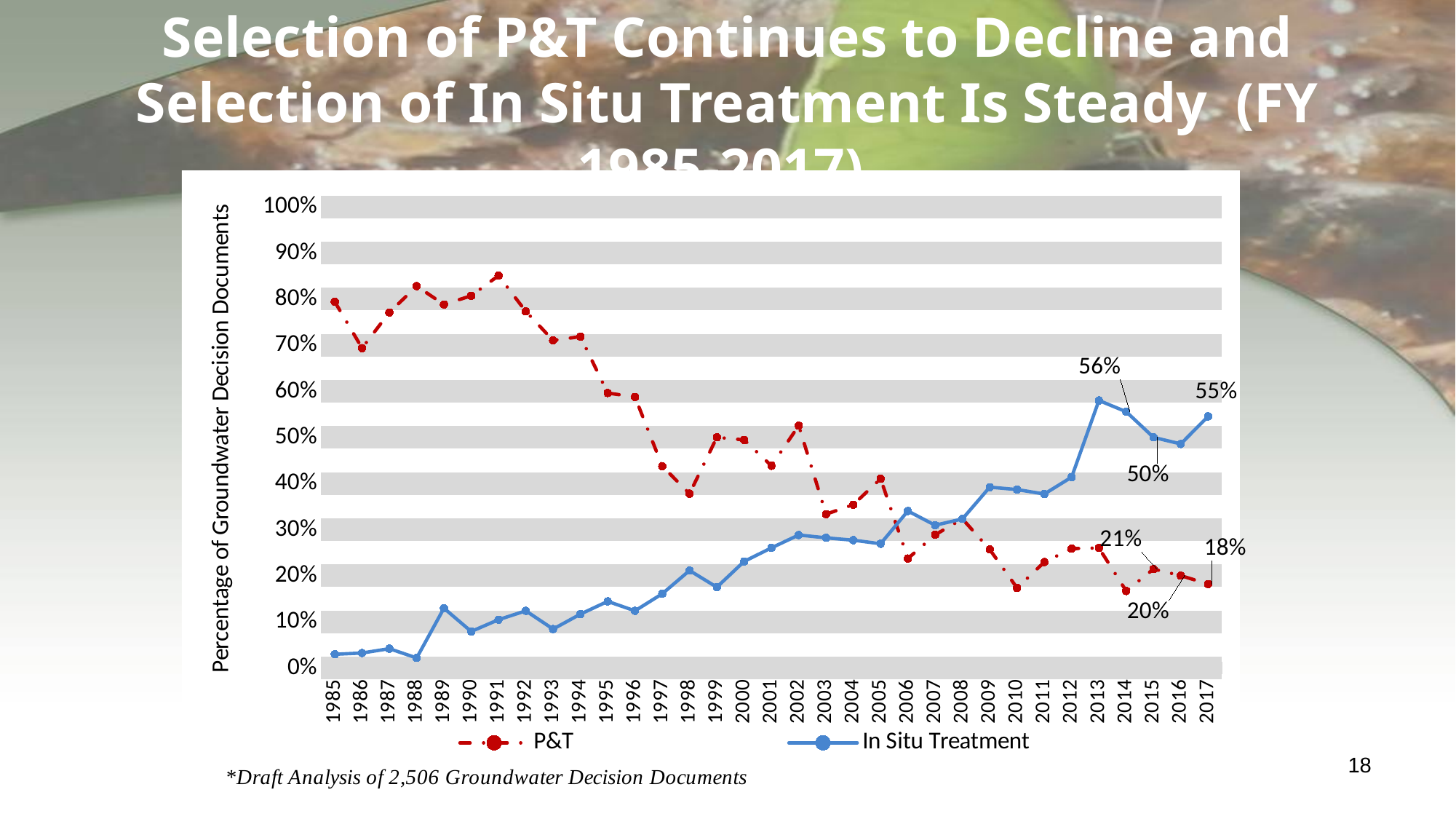
Is the value for P&T in 1985 greater or less than 70%? greater Is the value for In Situ Treatment in 1985 greater or less than 10%? less What is the value for P&T in 2017? 18% What is the difference between the In Situ Treatment and P&T values in 2017? 37 percentage points What is the label on the vertical axis? Percentage of Groundwater Decision Documents What is the value for In Situ Treatment in 2017? 55% In which year does the P&T series reach its highest value? 1991 What is the value for In Situ Treatment in 2015? 50% In 2017, which series has the larger value, P&T or In Situ Treatment? In Situ Treatment How many series does the legend list? 2 What kind of chart is shown on the slide? Line chart Does the P&T series generally rise or fall from 1985 to 2017? Fall